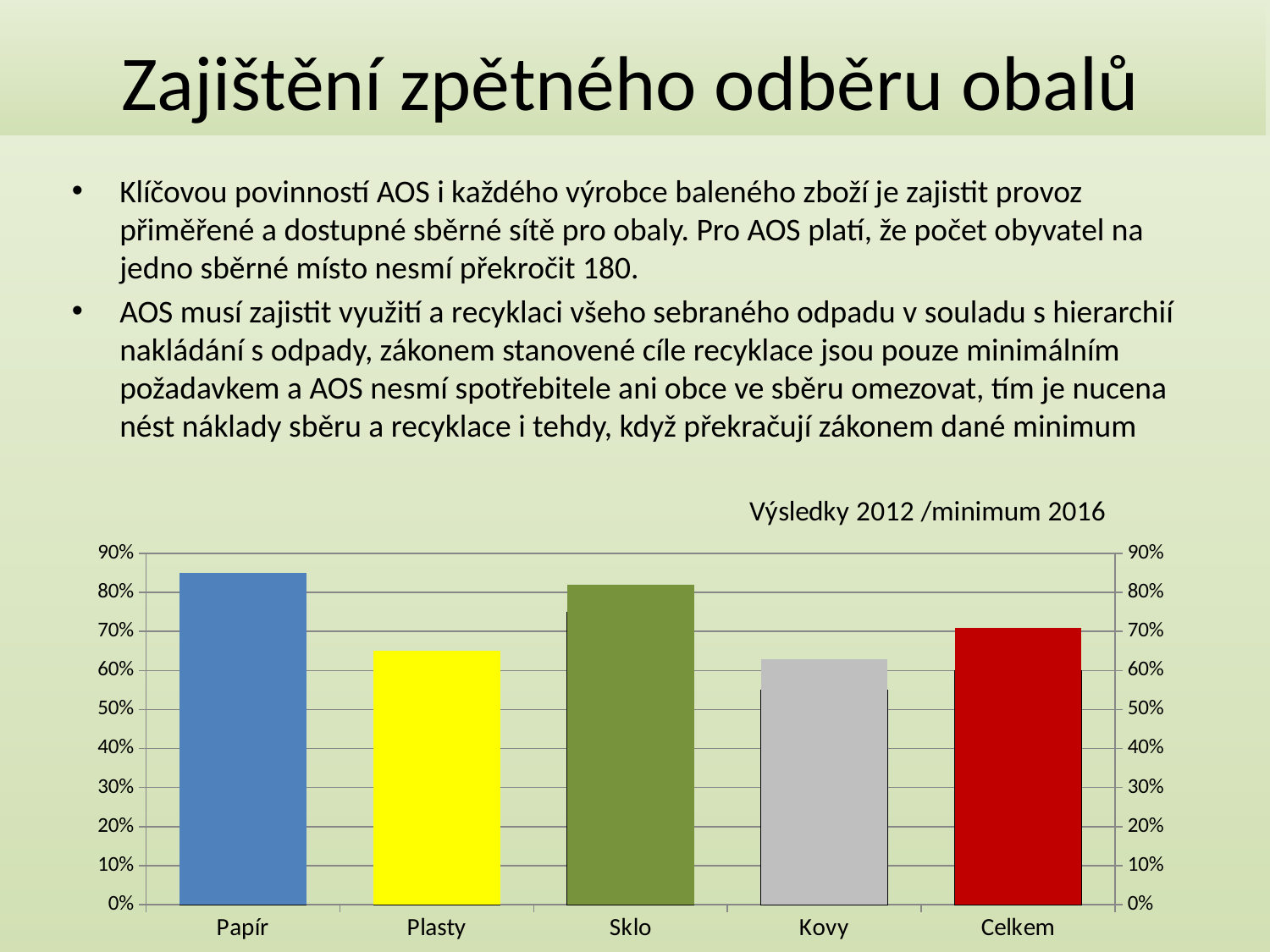
What is the title of the chart? Výsledky 2012 /minimum 2016 Is the value for Plasty greater or less than 70%? less Is the value for Celkem greater or less than 80%? less What kind of chart is shown on the slide? bar chart How many categories are shown on the x axis of the chart? 5 Which category has the highest bar in the chart? Papír What colour is the bar for Plasty? yellow Which is larger, the value for Papír or the value for Plasty? Papír Is the value for Papír greater or less than 80%? greater Which is larger, the value for Sklo or the value for Kovy? Sklo